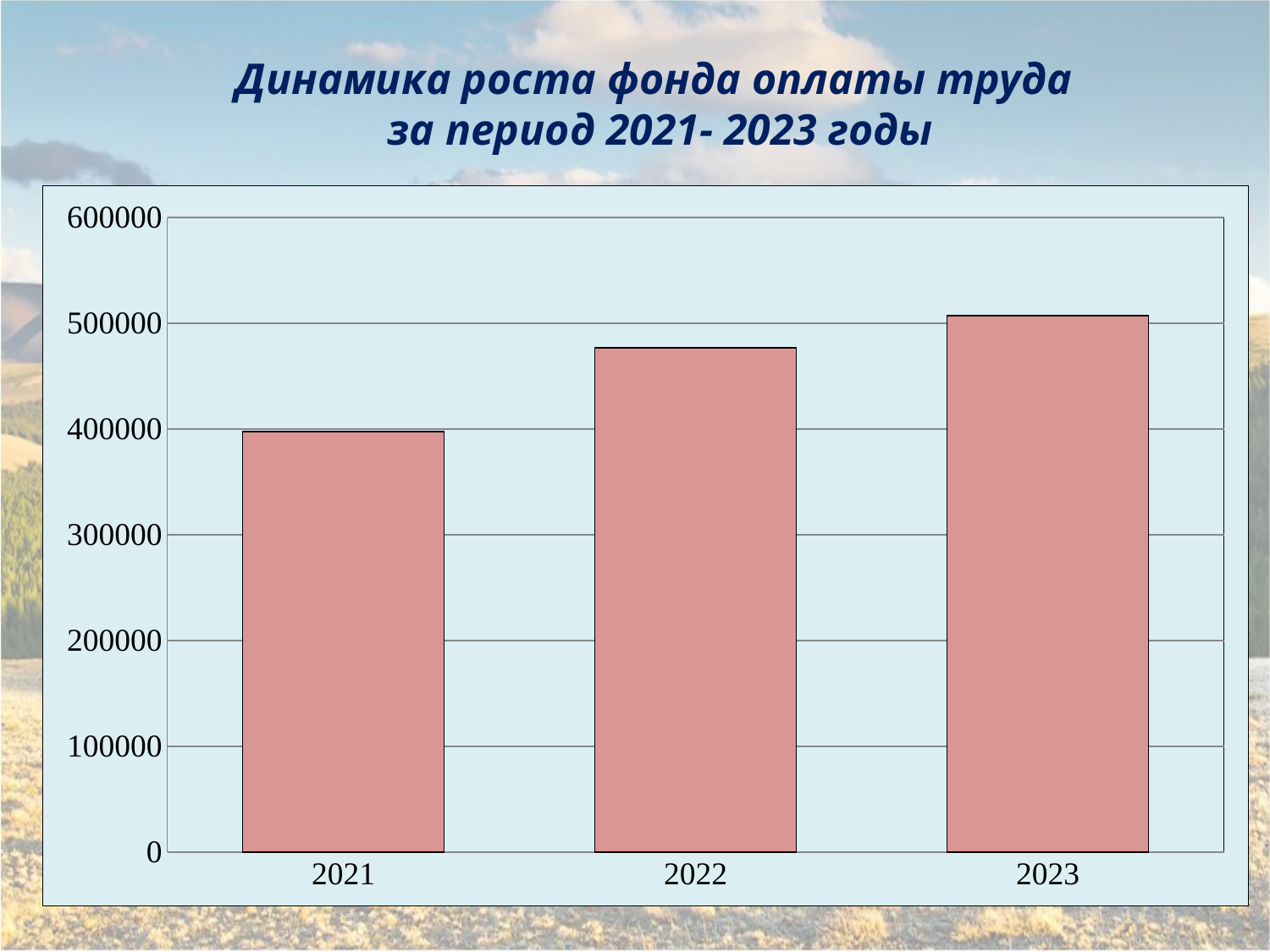
Which year has the highest value in the chart? 2023 What is the highest value shown on the vertical axis? 600000 Which year has the lowest value in the chart? 2021 Which is larger, the value for 2021 or the value for 2022? 2022 Do the values rise or fall from 2021 to 2023? rise Is the value for 2021 greater or less than 300000? greater Is the value for 2023 greater or less than 400000? greater What is the title of the slide? Динамика роста фонда оплаты труда за период 2021- 2023 годы Is the value for 2022 greater or less than 500000? less What kind of chart is shown on the slide? bar chart How many bars (years) are shown in the chart? 3